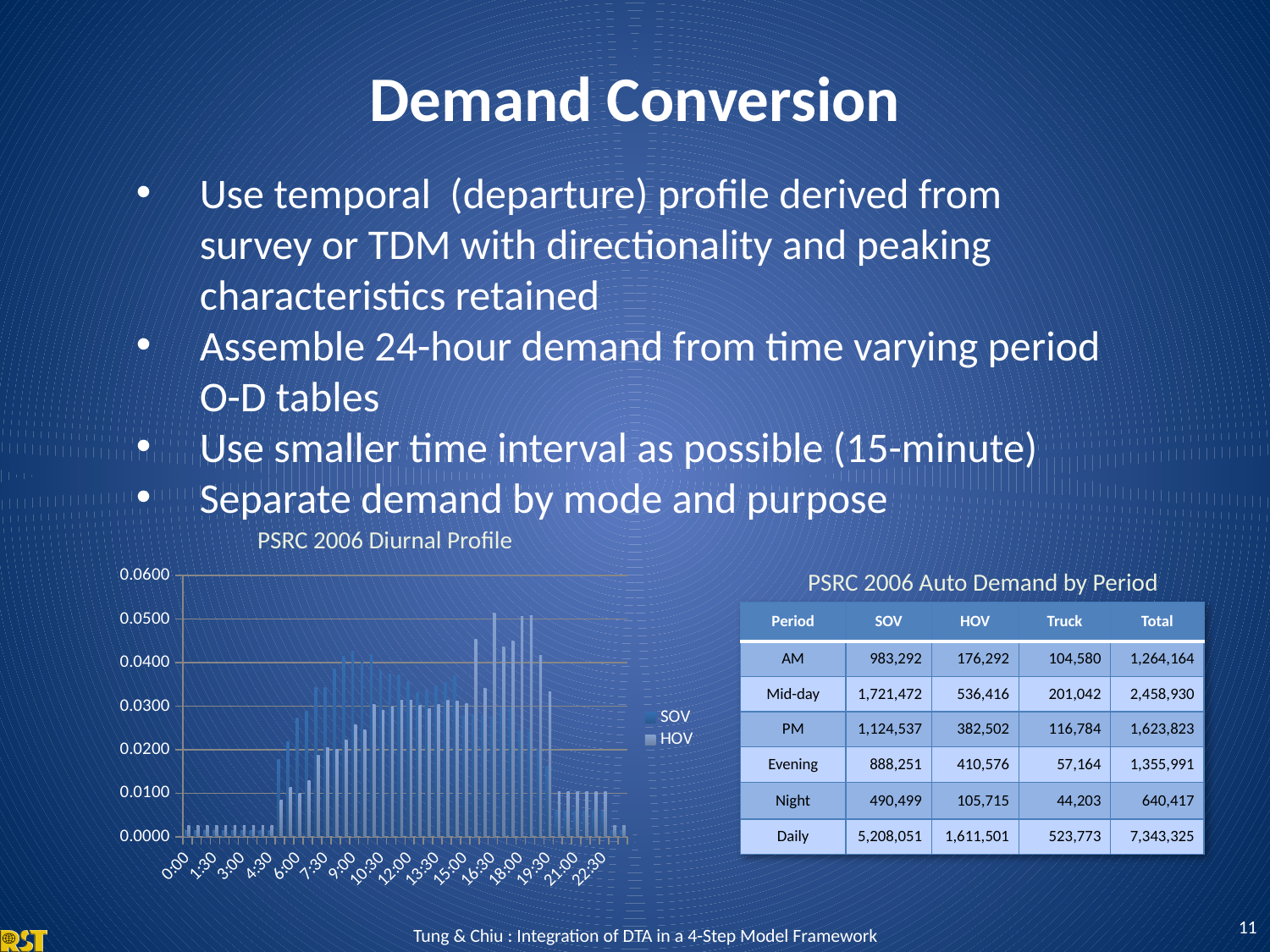
In the PSRC 2006 Diurnal Profile chart, is the SOV value at 12:00 greater or less than 0.0200? greater In the PSRC 2006 Diurnal Profile chart, is the highest SOV value around 18:00 greater or less than 0.0400? less In the PSRC 2006 Diurnal Profile chart, which series is larger at 18:00, SOV or HOV? HOV What kind of chart is the PSRC 2006 Diurnal Profile? bar chart In the PSRC 2006 Diurnal Profile chart, is the SOV value at 0:00 greater or less than 0.0100? less What is the title of the bar chart on the slide? PSRC 2006 Diurnal Profile What are the two series named in the legend of the PSRC 2006 Diurnal Profile chart? SOV and HOV How many series does the legend of the PSRC 2006 Diurnal Profile chart list? 2 In the PSRC 2006 Diurnal Profile chart, do the SOV values rise or fall between 18:00 and 22:30? fall In the PSRC 2006 Diurnal Profile chart, do the SOV values rise or fall between 4:30 and 7:30? rise How many time labels are printed along the x axis of the PSRC 2006 Diurnal Profile chart? 16